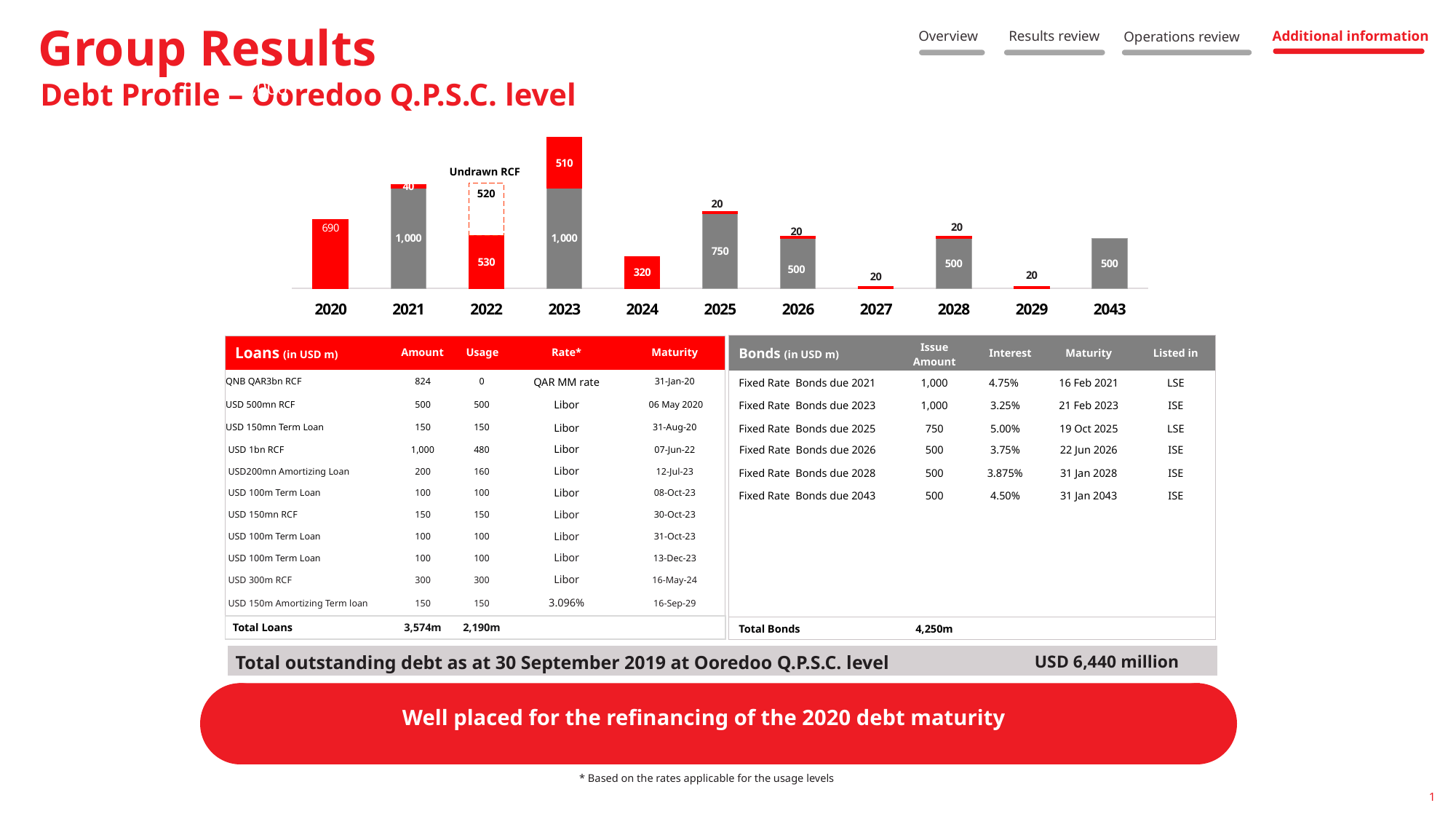
What is the difference between the red segment for 2020 and the red segment for 2024 in the debt maturity chart? 370 What is the value of the red segment for 2024 in the debt maturity chart? 320 How many years are shown on the x axis of the debt maturity chart? 11 What value is shown for the dashed 'Undrawn RCF' box above the 2022 bar in the debt maturity chart? 520 What is the value of the red segment for 2022 in the debt maturity chart? 530 What is the total of the stacked bar for 2021 in the debt maturity chart? 1,040 What is the value of the red segment for 2020 in the debt maturity chart? 690 What is the total of the stacked bar for 2023 in the debt maturity chart? 1,510 Which is larger in the debt maturity chart: the bar for 2020 or the bar for 2024? 2020 What is the value of the grey segment for 2025 in the debt maturity chart? 750 Which year has the tallest stacked bar in the debt maturity chart? 2023 What is the value of the grey segment for 2023 in the debt maturity chart? 1,000